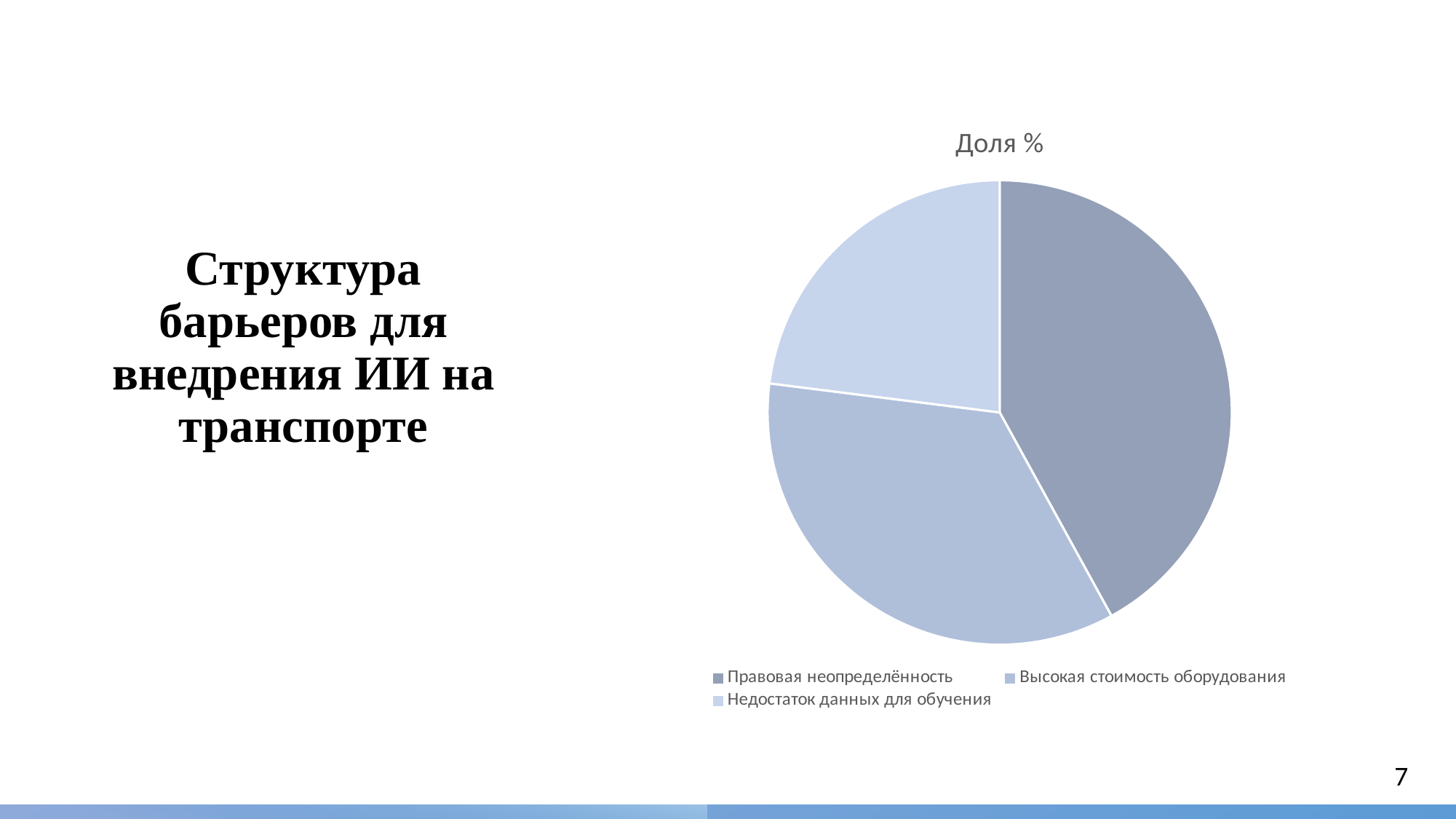
Which slice is larger: Правовая неопределённость or Высокая стоимость оборудования? Правовая неопределённость Which category has the smallest slice in the pie chart? Недостаток данных для обучения Which slice is larger: Высокая стоимость оборудования or Недостаток данных для обучения? Высокая стоимость оборудования Which category has the largest slice in the pie chart? Правовая неопределённость How many slices does the pie chart have? 3 What kind of chart is shown on the slide? pie chart Which legend entry is shown in the darkest shade in the pie chart? Правовая неопределённость What is the title of the pie chart? Доля % How many entries does the legend of the pie chart list? 3